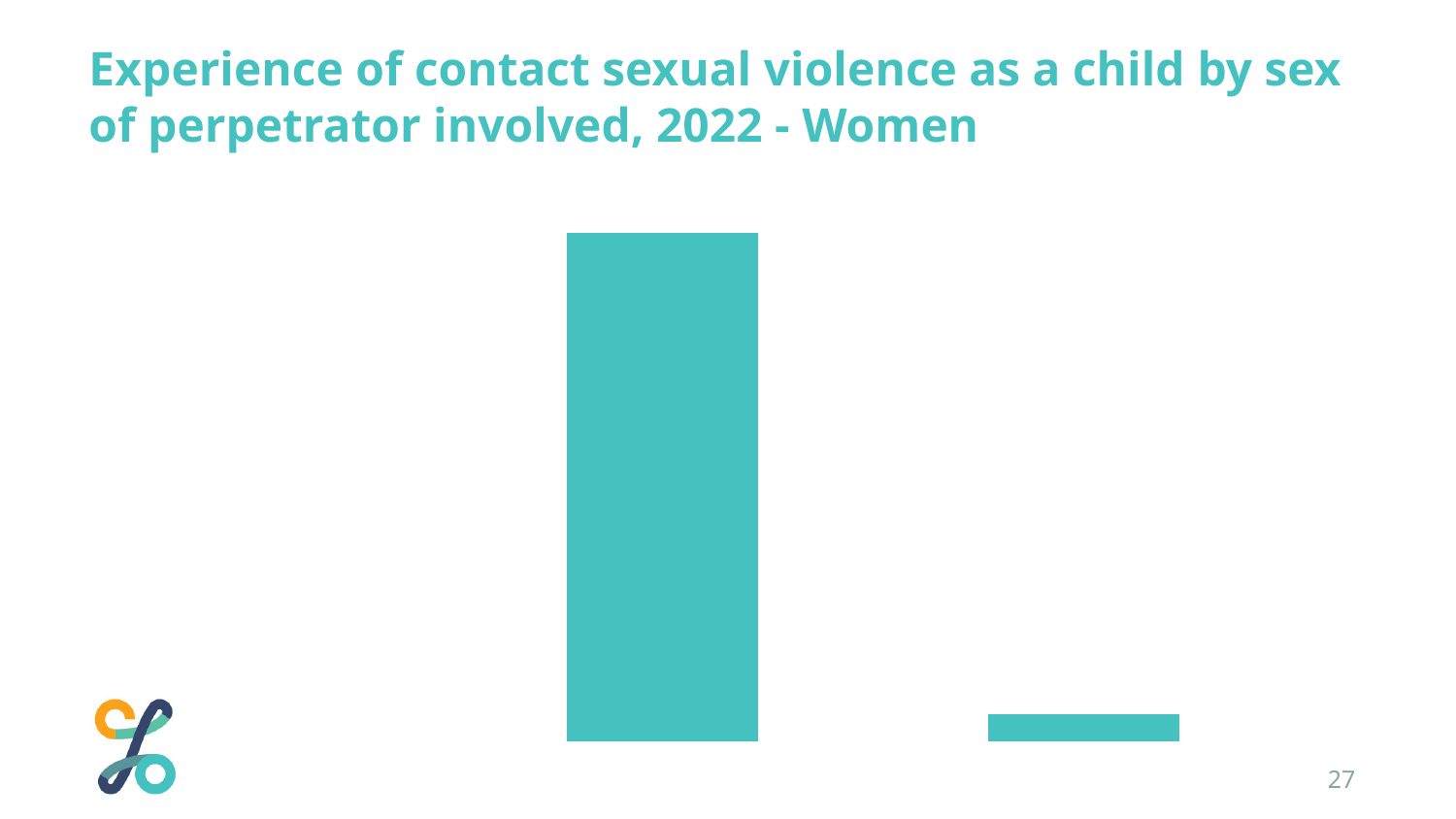
Which bar is taller, the left bar or the right bar? the left bar Which bar is the shortest in the chart? the right bar What kind of chart is shown on the slide? bar chart Do the bar heights rise or fall from left to right? fall Which bar is the tallest in the chart? the left bar How many bars are plotted in the chart? 2 What colour are the bars in the chart? teal What is the title of the chart on the slide? Experience of contact sexual violence as a child by sex of perpetrator involved, 2022 - Women